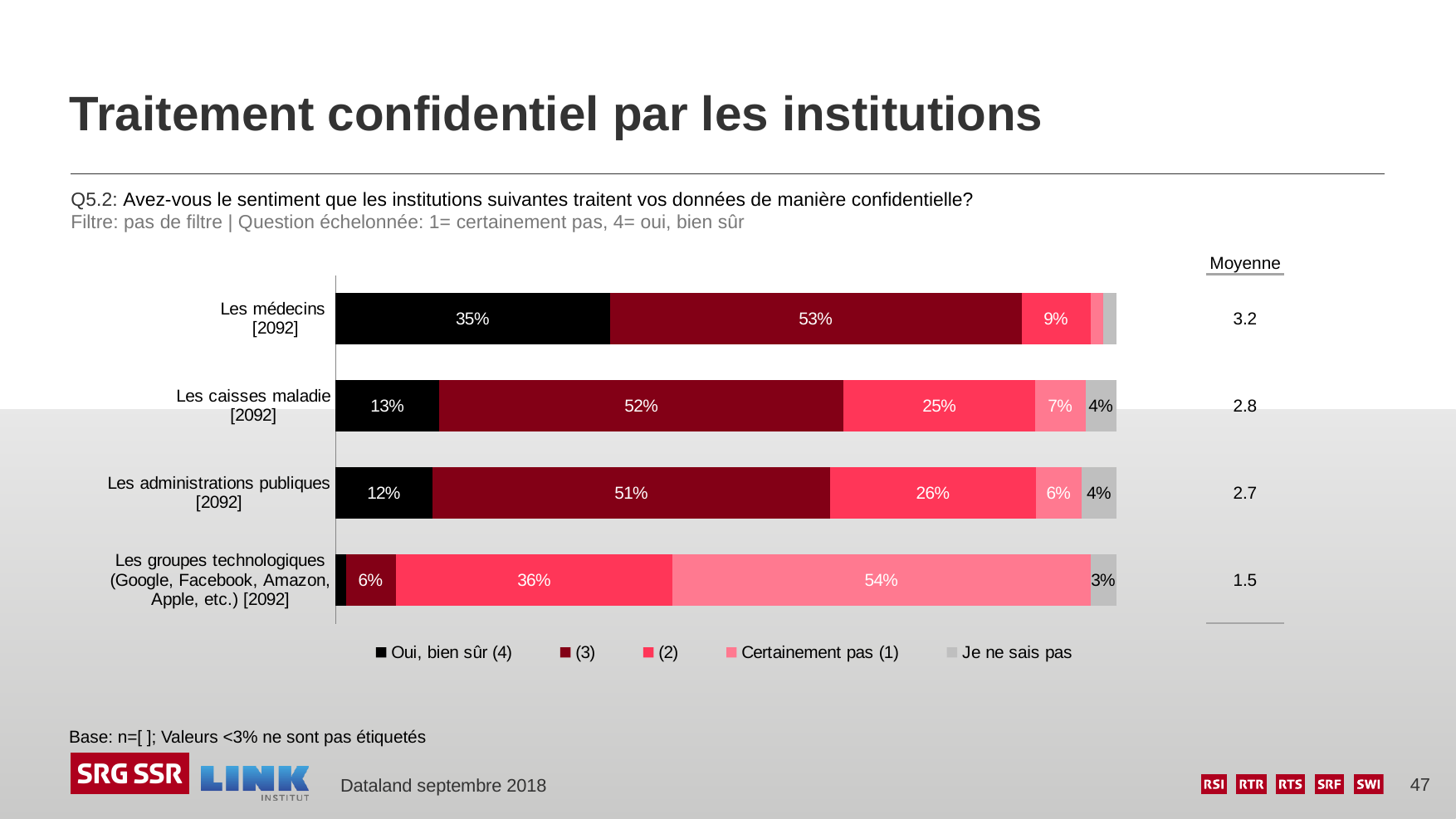
What is the "Certainement pas (1)" value for Les groupes technologiques (Google, Facebook, Amazon, Apple, etc.)? 54% Which institution has the lowest Moyenne? Les groupes technologiques (Google, Facebook, Amazon, Apple, etc.) Which institution has the highest "Oui, bien sûr (4)" share? Les médecins What percentage answered "(2)" for Les administrations publiques? 26% How many institutions are shown in the chart? 4 What is the Moyenne shown for Les médecins? 3.2 Which is larger: the "Oui, bien sûr (4)" value for Les médecins or for Les caisses maladie? Les médecins What percentage of respondents answered "Oui, bien sûr (4)" for Les médecins? 35% What kind of chart is shown on the slide? Stacked bar chart How many series does the legend list? 5 What is the value of the "(3)" segment for Les caisses maladie? 52% What is the difference in percentage points between the "(2)" value for Les groupes technologiques and for Les caisses maladie? 11